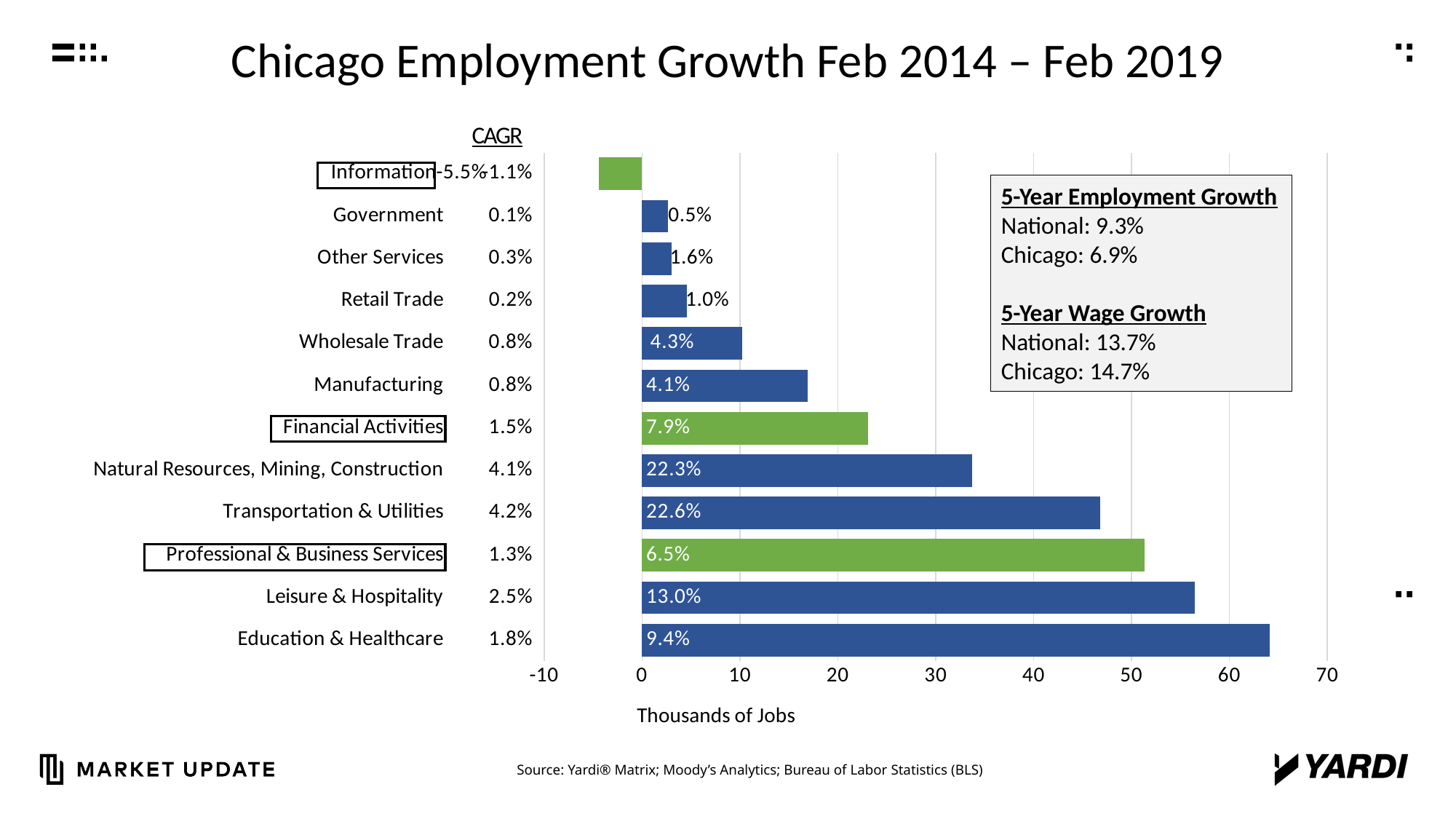
Is the value for Financial Activities greater or less than 30 thousand jobs? less Which category has the lowest value (the only negative bar)? Information What is the CAGR listed for Transportation & Utilities? 4.2% How many industry categories are plotted in the chart? 12 Is the value for Education & Healthcare greater or less than 60 thousand jobs? greater Which bar is longer: Transportation & Utilities or Natural Resources, Mining, Construction? Transportation & Utilities What percentage label is shown on the bar for Natural Resources, Mining, Construction? 22.3% What kind of chart is shown on the slide? bar chart Which category has the longest bar (largest job growth in thousands of jobs)? Education & Healthcare What is the label on the horizontal axis of the chart? Thousands of Jobs What percentage label is shown on the bar for Information? -5.5% What is the difference between the percentage labels on the Leisure & Hospitality bar (13.0%) and the Education & Healthcare bar (9.4%)? 3.6%